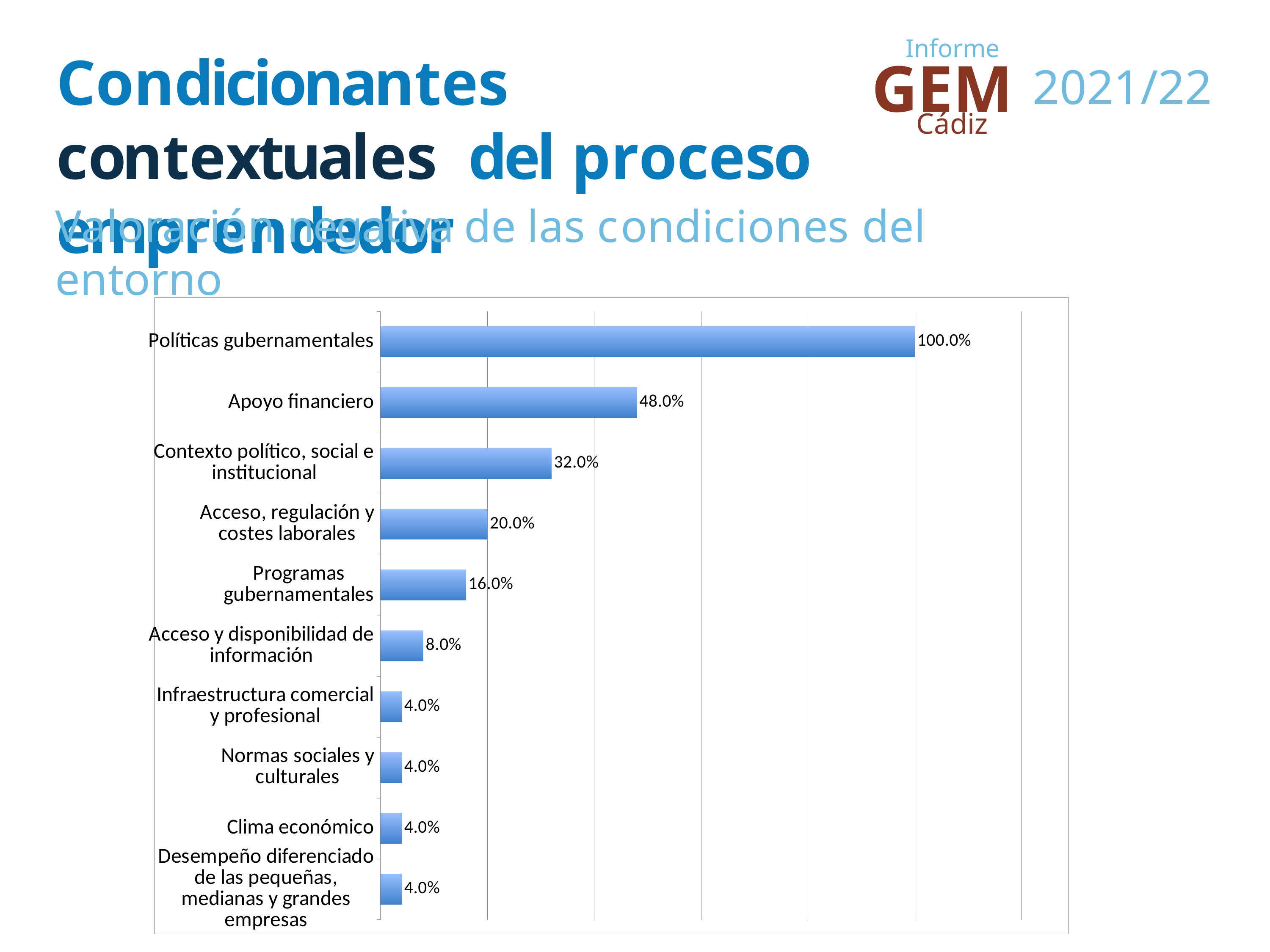
How many categories have a value of 4.0%? 4 What is the value for Contexto político, social e institucional? 32.0% What is the value for Acceso y disponibilidad de información? 8.0% How many categories are shown in the chart? 10 What kind of chart is shown on the slide? Bar chart What is the difference between the values for Acceso, regulación y costes laborales and Programas gubernamentales? 4.0% What is the difference between the values for Políticas gubernamentales and Apoyo financiero? 52.0% What is the value for Políticas gubernamentales? 100.0% Which is larger, the value for Contexto político, social e institucional or the value for Acceso, regulación y costes laborales? Contexto político, social e institucional What is the value for Apoyo financiero? 48.0% What is the value for Programas gubernamentales? 16.0% Which category has the highest value? Políticas gubernamentales